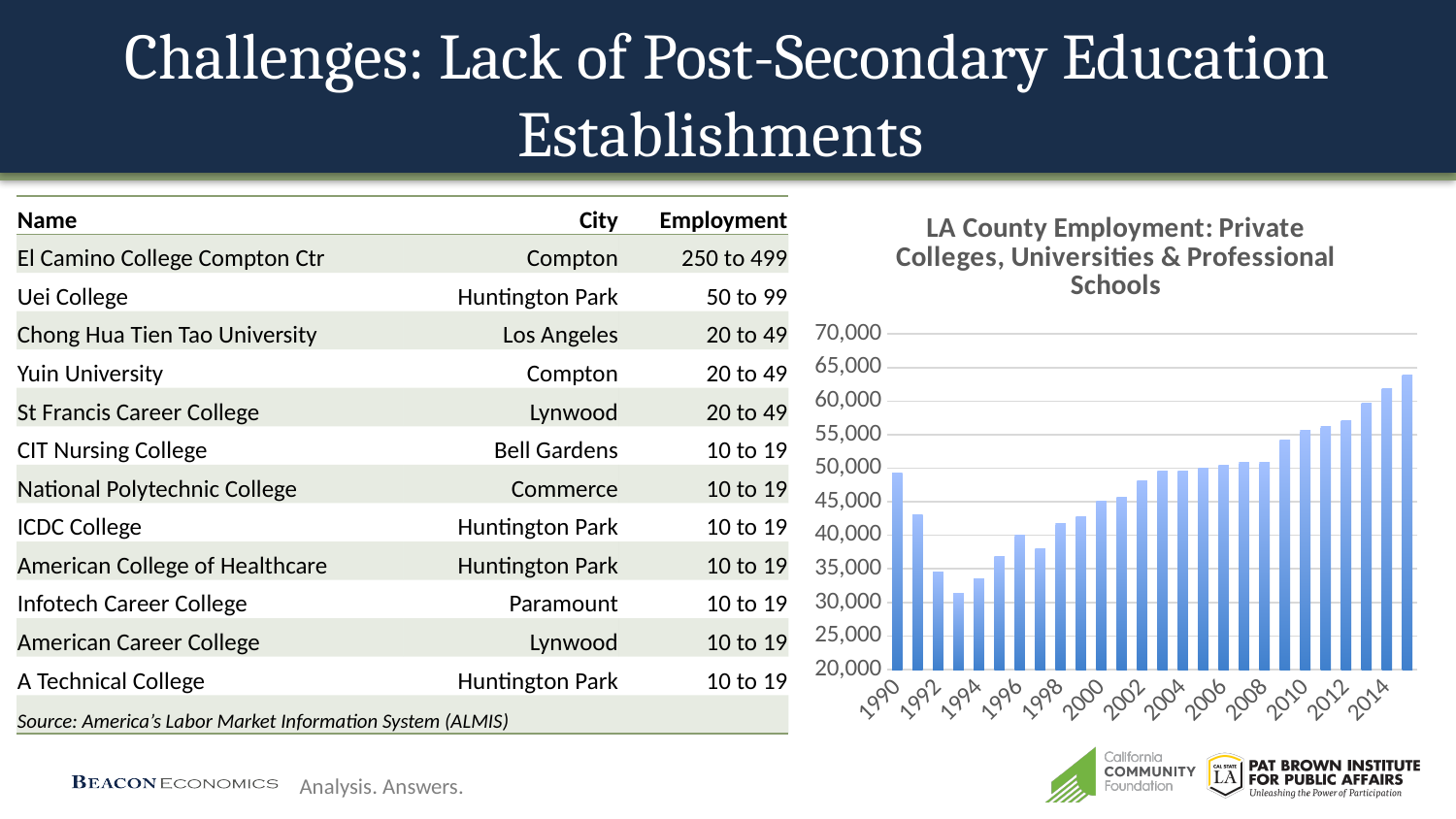
What kind of chart is shown on the right side of the slide? bar chart In the LA County Employment chart, is the value for 2010 greater or less than 50,000? greater In the LA County Employment chart, do the values generally rise or fall from 2000 to 2014? rise What is the highest value shown on the vertical axis of the LA County Employment chart? 70,000 In the LA County Employment chart, is the value for 1994 greater or less than 35,000? less In the LA County Employment chart, is the value for 2000 greater or less than 40,000? greater In the LA County Employment chart, which year has the larger value, 1990 or 1992? 1990 What is the title of the chart on the slide? LA County Employment: Private Colleges, Universities & Professional Schools In the LA County Employment chart, which year has the larger value, 2014 or 1990? 2014